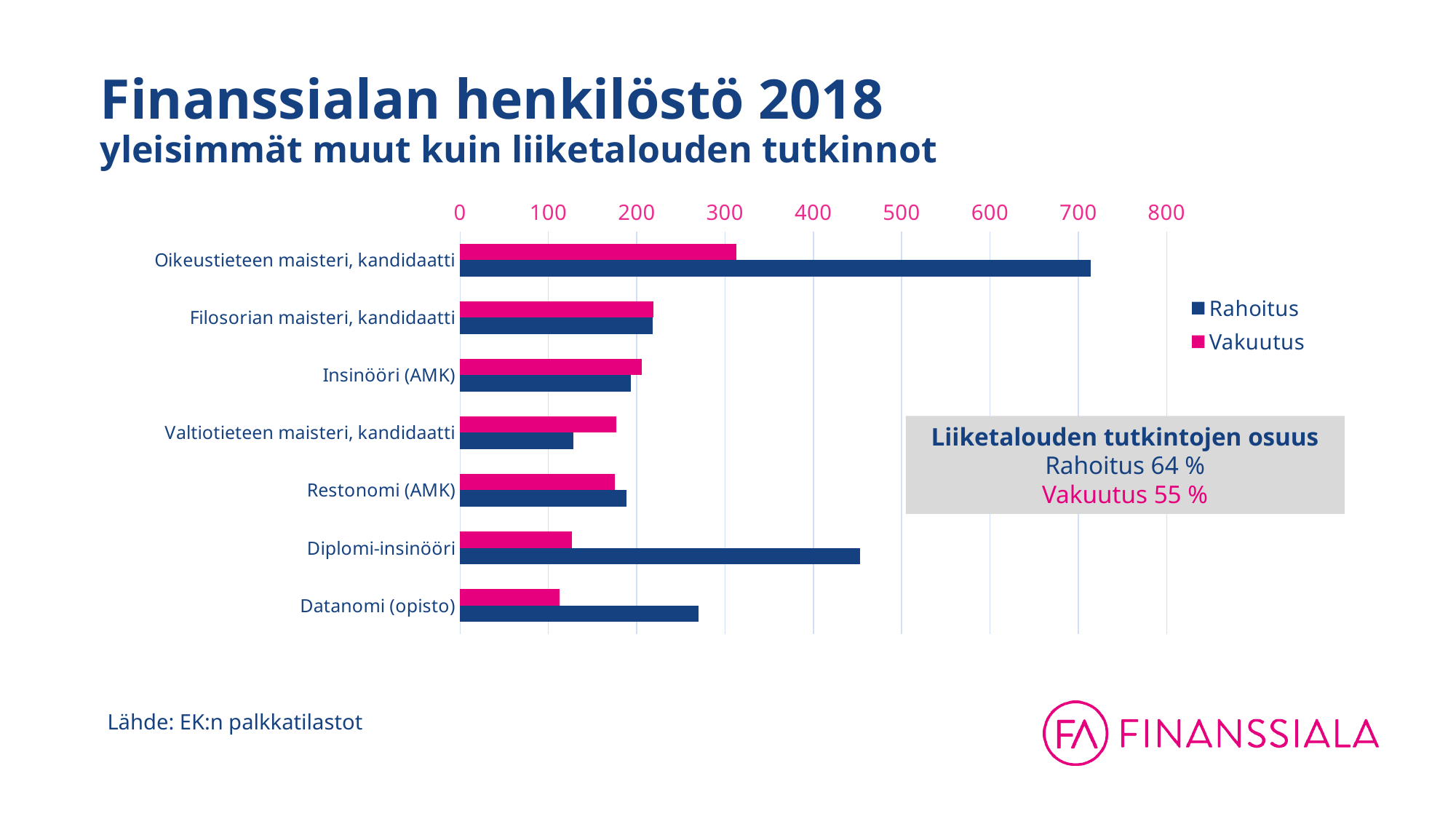
What kind of chart is shown on the slide? bar chart Which category has the highest Vakuutus value? Oikeustieteen maisteri, kandidaatti For Valtiotieteen maisteri, kandidaatti, which is larger, the Rahoitus value or the Vakuutus value? Vakuutus Is the Rahoitus value for Datanomi (opisto) greater or less than 200? greater For Diplomi-insinööri, which is larger, the Rahoitus value or the Vakuutus value? Rahoitus Is the Rahoitus value for Diplomi-insinööri greater or less than 500? less Is the Rahoitus value for Oikeustieteen maisteri, kandidaatti greater or less than 700? greater Which colour represents the Vakuutus series in the legend? pink Which category has the lowest Rahoitus value? Valtiotieteen maisteri, kandidaatti How many series does the legend list? 2 Which category has the highest Rahoitus value? Oikeustieteen maisteri, kandidaatti How many degree categories are shown on the chart? 7